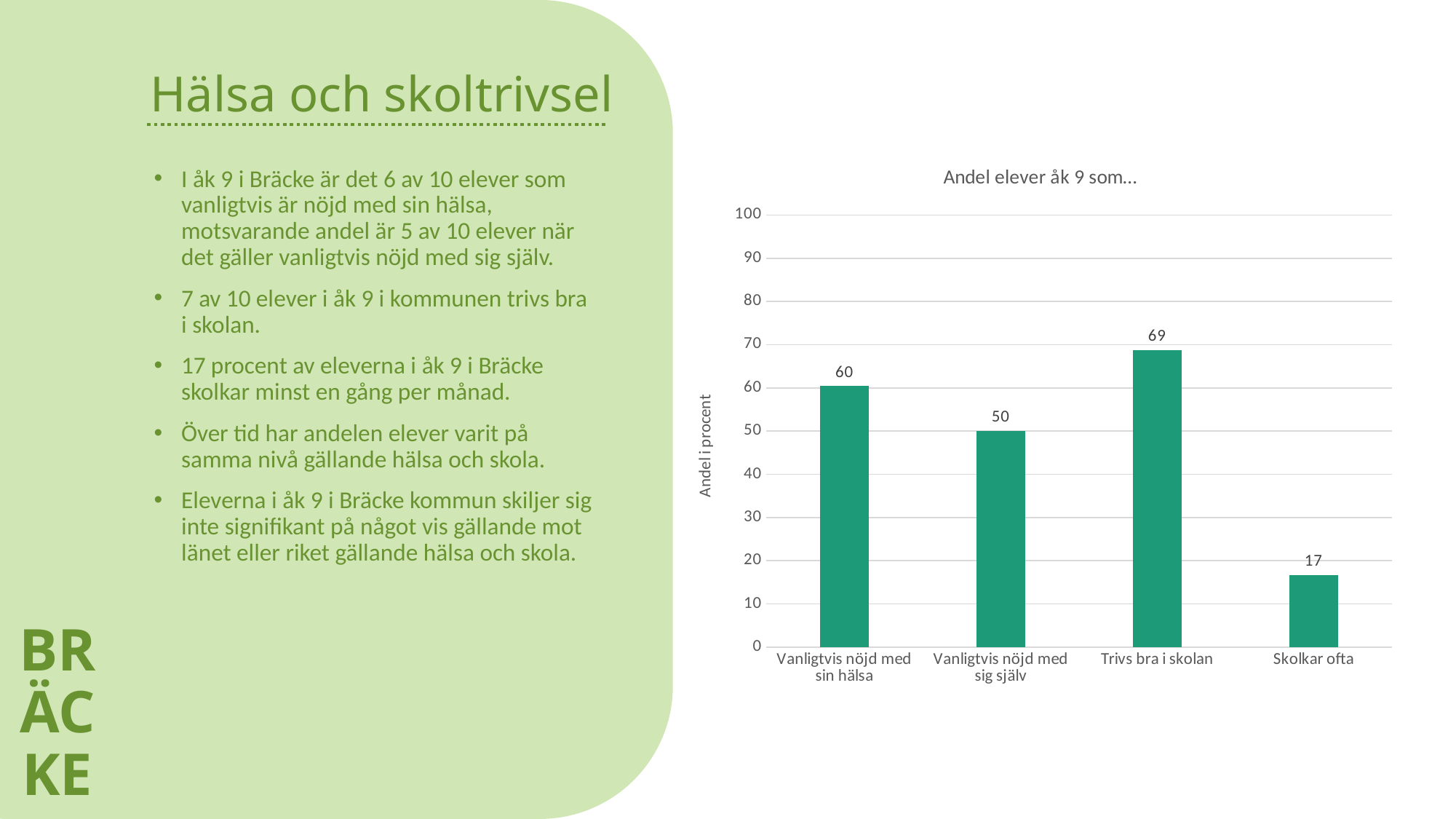
What is the label of the vertical axis? Andel i procent What is the value for "Trivs bra i skolan"? 69 Which category has the lowest value? Skolkar ofta What is the value for "Vanligtvis nöjd med sig själv"? 50 What kind of chart is shown on the slide? Bar chart What is the title of the chart? Andel elever åk 9 som… What is the value for "Skolkar ofta"? 17 Which is larger: the value for "Vanligtvis nöjd med sin hälsa" or "Vanligtvis nöjd med sig själv"? Vanligtvis nöjd med sin hälsa What is the difference between the values for "Trivs bra i skolan" and "Vanligtvis nöjd med sin hälsa"? 9 How many categories are shown in the chart? 4 Which category has the highest value? Trivs bra i skolan What is the value for "Vanligtvis nöjd med sin hälsa"? 60